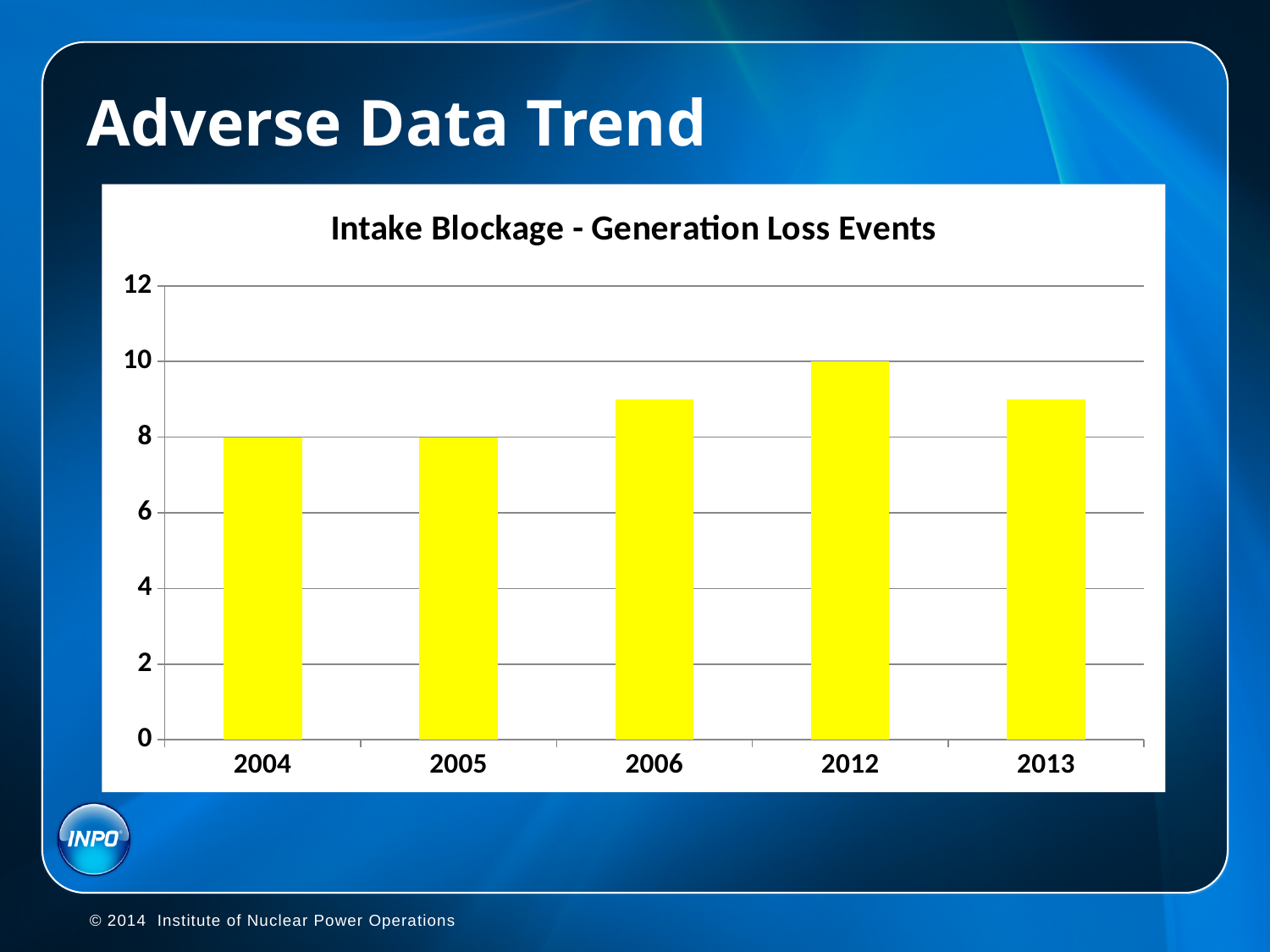
What is the value for 2005? 8 What is the difference between the values for 2012 and 2004? 2 Which is larger, the value for 2006 or the value for 2004? 2006 Is the value for 2013 greater or less than 10? less What kind of chart is shown? bar chart Which is larger, the value for 2012 or the value for 2013? 2012 What is the title of the chart? Intake Blockage - Generation Loss Events What is the value for 2012? 10 How many years are shown on the x axis? 5 Which year has the highest value? 2012 Is the value for 2006 greater or less than 8? greater What is the value for 2004? 8